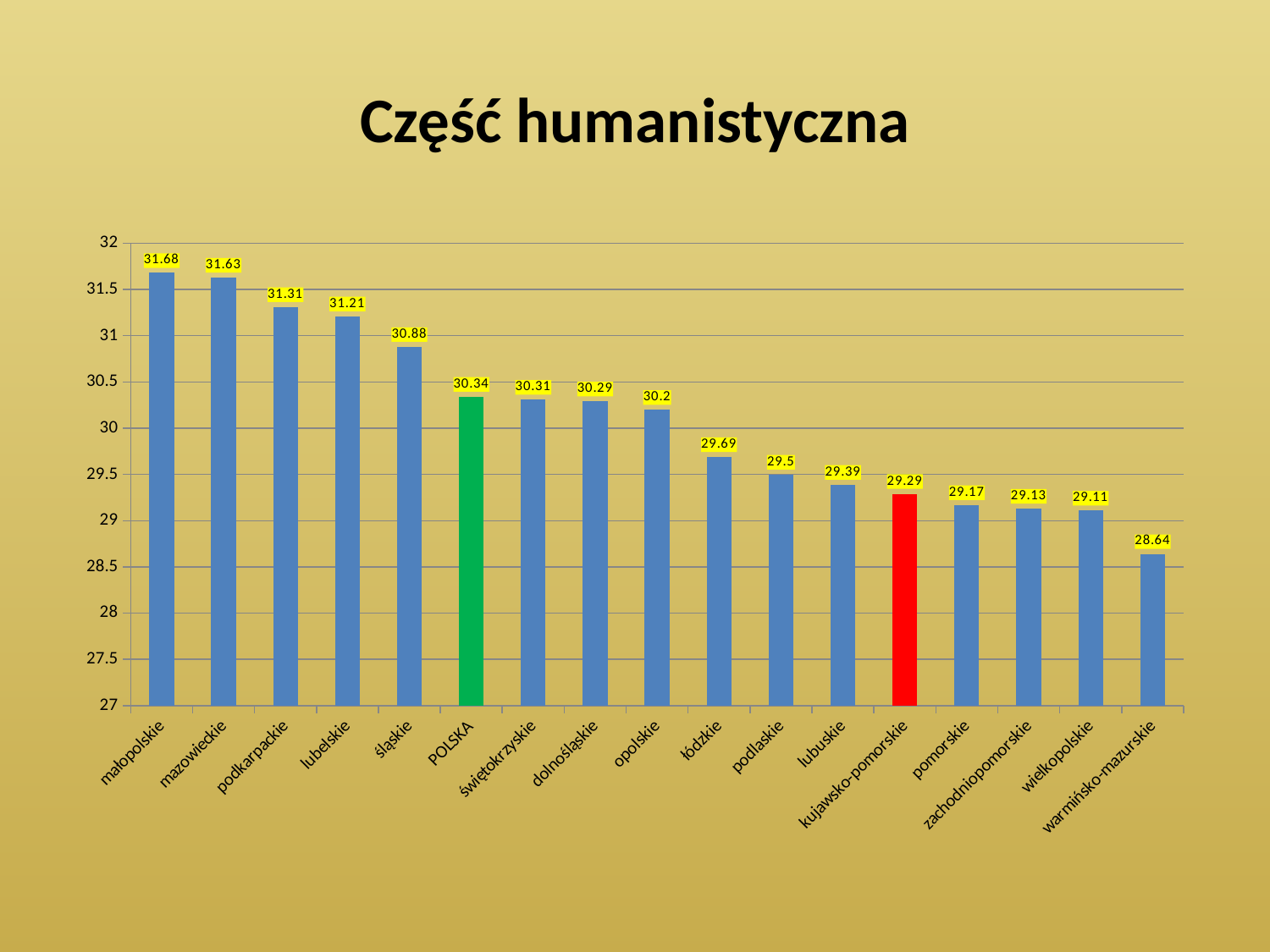
What is the difference between the values for małopolskie and warmińsko-mazurskie? 3.04 What is the difference between the values for POLSKA and kujawsko-pomorskie? 1.05 What is the value for POLSKA? 30.34 Which is larger, the value for śląskie or the value for łódzkie? śląskie How many categories are shown on the x axis? 17 What is the value for kujawsko-pomorskie? 29.29 Do the values rise or fall from left to right along the x axis? fall Which category has the highest value? małopolskie Which category has the lowest value? warmińsko-mazurskie What is the value for małopolskie? 31.68 What kind of chart is shown on the slide? bar chart What is the value for warmińsko-mazurskie? 28.64